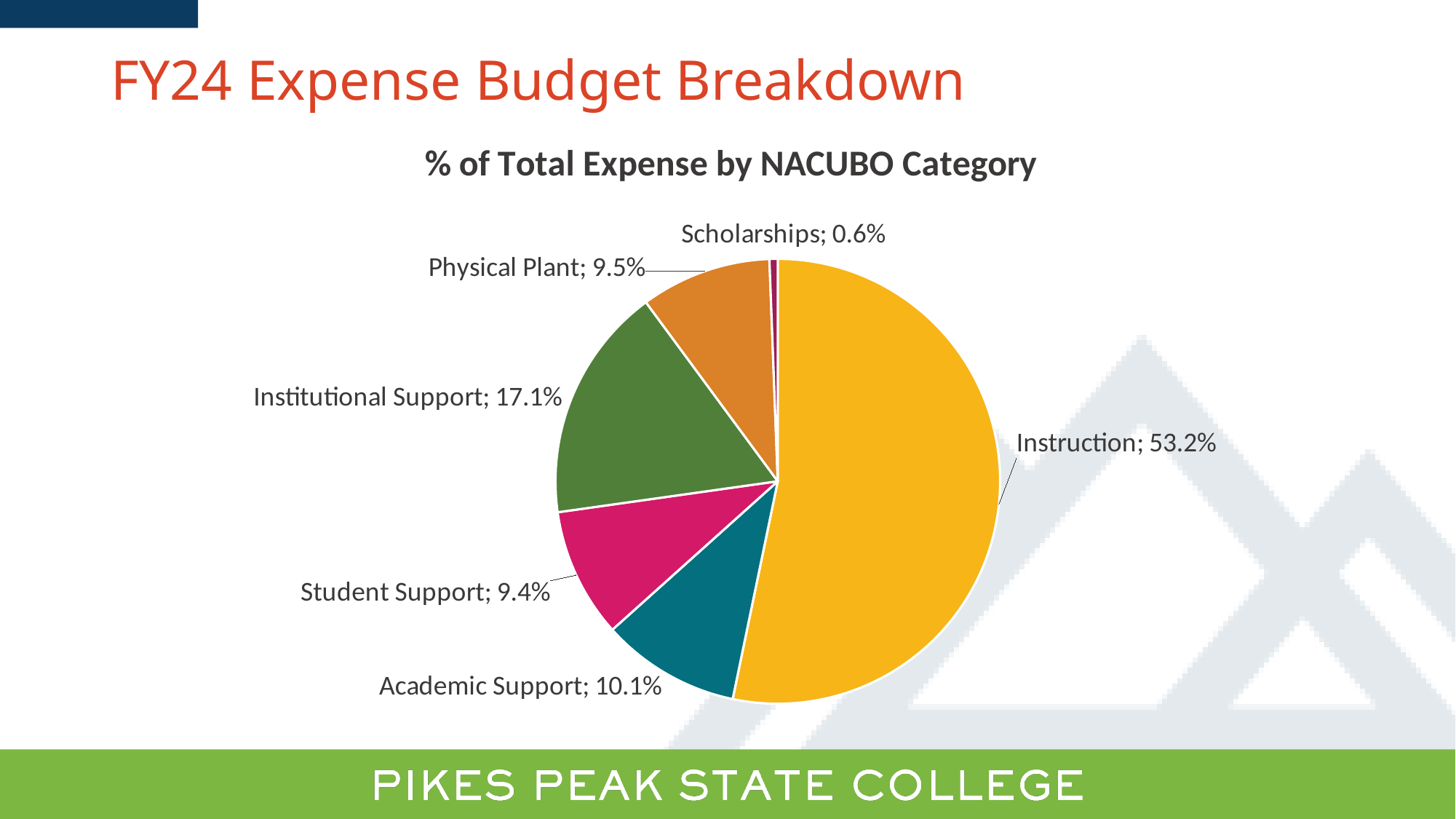
What percentage of total expense is Academic Support? 10.1% How many categories are shown in the pie chart? 6 What type of chart is shown on the slide? Pie chart What is the difference in percentage points between Instruction and Institutional Support? 36.1 What percentage of total expense is Institutional Support? 17.1% What colour is the Instruction slice? Yellow Which category has the largest share of total expense? Instruction What percentage of total expense is Instruction? 53.2% Which is larger, Physical Plant or Academic Support? Academic Support What percentage of total expense is Scholarships? 0.6% What is the title of the chart? % of Total Expense by NACUBO Category Which category has the smallest share of total expense? Scholarships